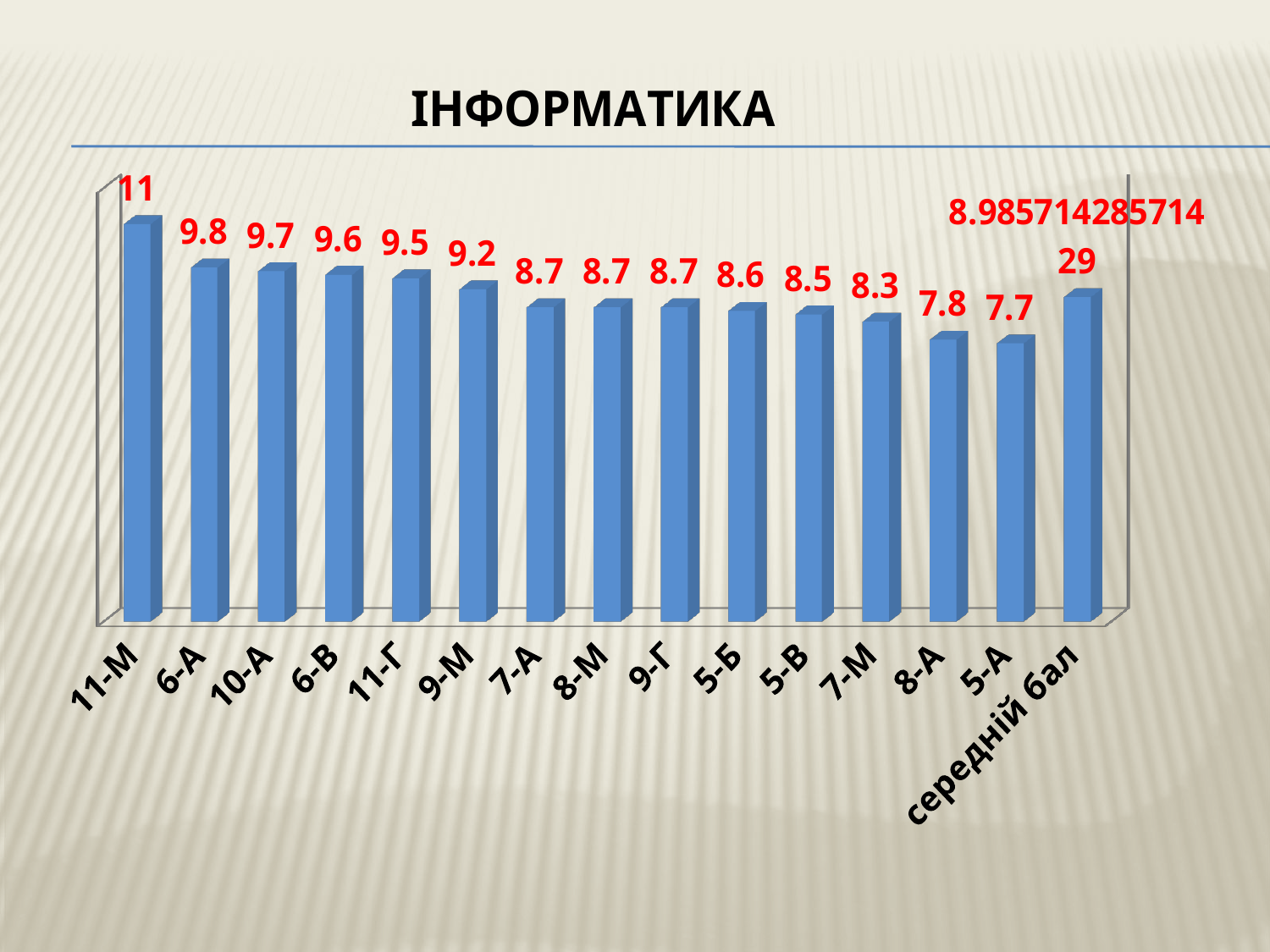
How many bars are shown in the chart? 15 What is the value for 6-А? 9.8 What is the value for 7-М? 8.3 Which class has the highest value? 11-М What is the value shown for середній бал? 8.98571428571429 What is the difference between the values for 11-М and 5-А? 3.3 What type of chart is shown on the slide? bar chart What is the value for 5-А? 7.7 Which is larger, the value for 10-А or the value for 9-М? 10-А What is the title of the slide? ІНФОРМАТИКА Which class has the lowest value? 5-А What is the value for 11-М? 11